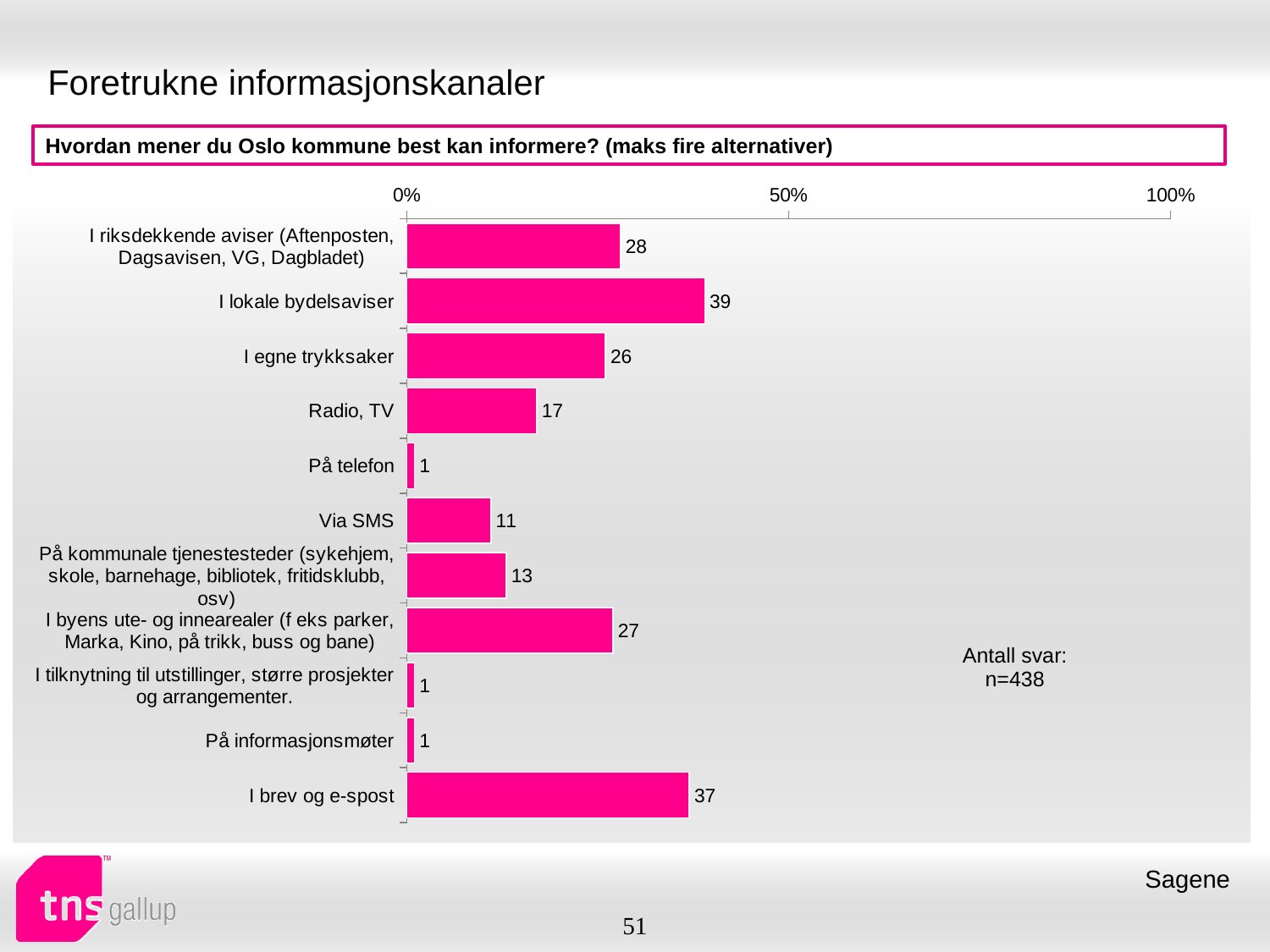
What is the value for "På telefon"? 1 What is the difference between the values for "I lokale bydelsaviser" and "I brev og e-spost"? 2 What is the value for "Radio, TV"? 17 What is the value for "I brev og e-spost"? 37 Which is larger, the value for "I egne trykksaker" or the value for "I riksdekkende aviser (Aftenposten, Dagsavisen, VG, Dagbladet)"? I riksdekkende aviser (Aftenposten, Dagsavisen, VG, Dagbladet) How many categories are shown in the chart? 11 What kind of chart is shown on the slide? bar chart What is the value for "Via SMS"? 11 What is the number of responses (Antall svar) shown on the slide? n=438 What is the value for "I lokale bydelsaviser"? 39 Is the value for "I lokale bydelsaviser" greater or less than 50%? less Which category has the highest value? I lokale bydelsaviser